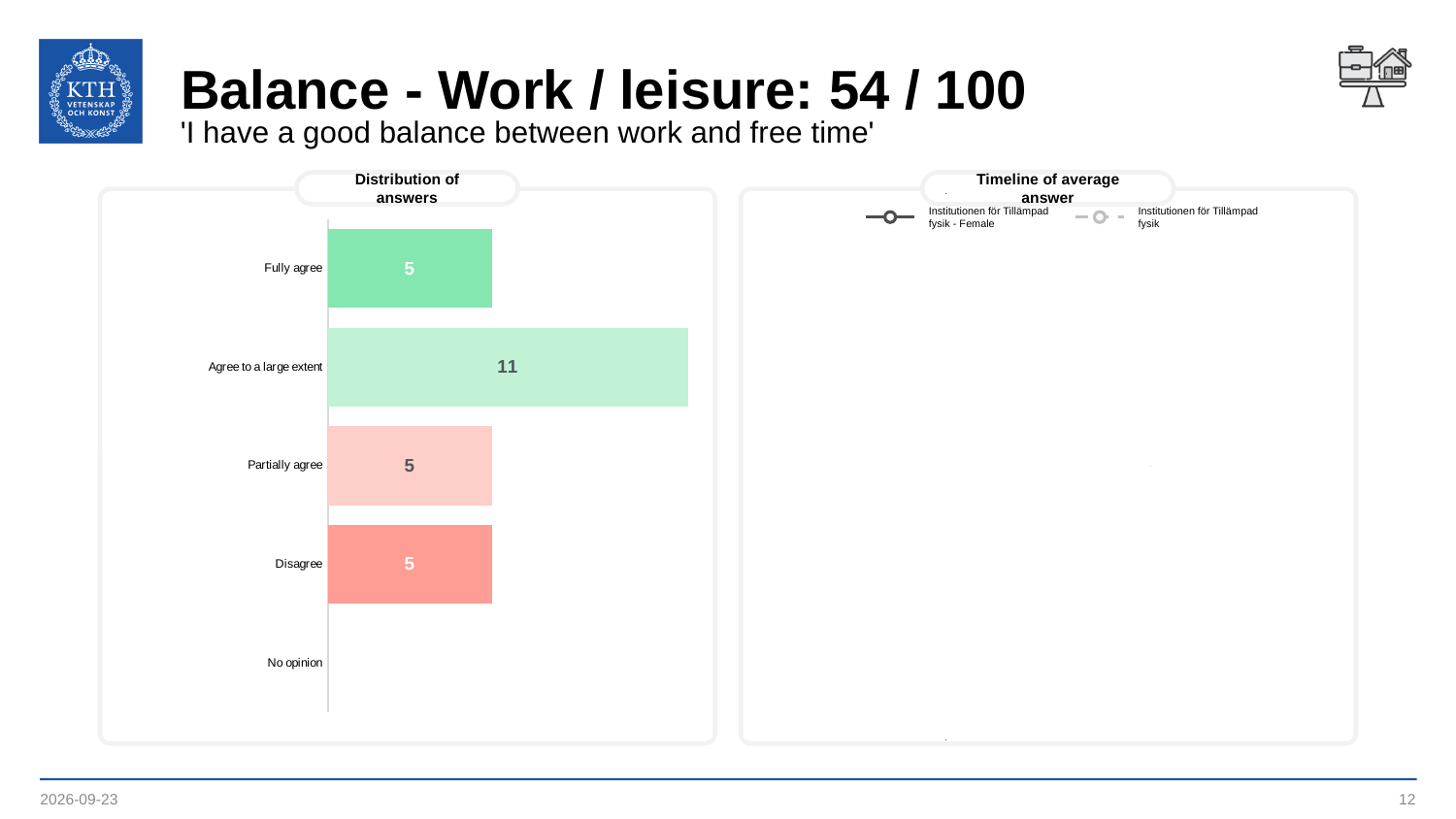
In the 'Distribution of answers' chart, what is the value for 'Agree to a large extent'? 11 What kind of chart is the 'Distribution of answers' chart? Bar chart In the 'Distribution of answers' chart, what is the value for 'Fully agree'? 5 In the 'Distribution of answers' chart, what is the value for 'Disagree'? 5 In the 'Distribution of answers' chart, what is the value for 'Partially agree'? 5 In the 'Distribution of answers' chart, which category has the highest value? Agree to a large extent How many series does the legend of the 'Timeline of average answer' chart list? 2 How many categories are listed on the axis of the 'Distribution of answers' chart? 5 In the 'Distribution of answers' chart, what is the total of the values for 'Fully agree', 'Agree to a large extent', 'Partially agree' and 'Disagree'? 26 What is the title of the chart on the right side of the slide? Timeline of average answer In the 'Distribution of answers' chart, what is the difference between 'Agree to a large extent' and 'Fully agree'? 6 In the 'Distribution of answers' chart, which is larger: 'Agree to a large extent' or 'Disagree'? Agree to a large extent